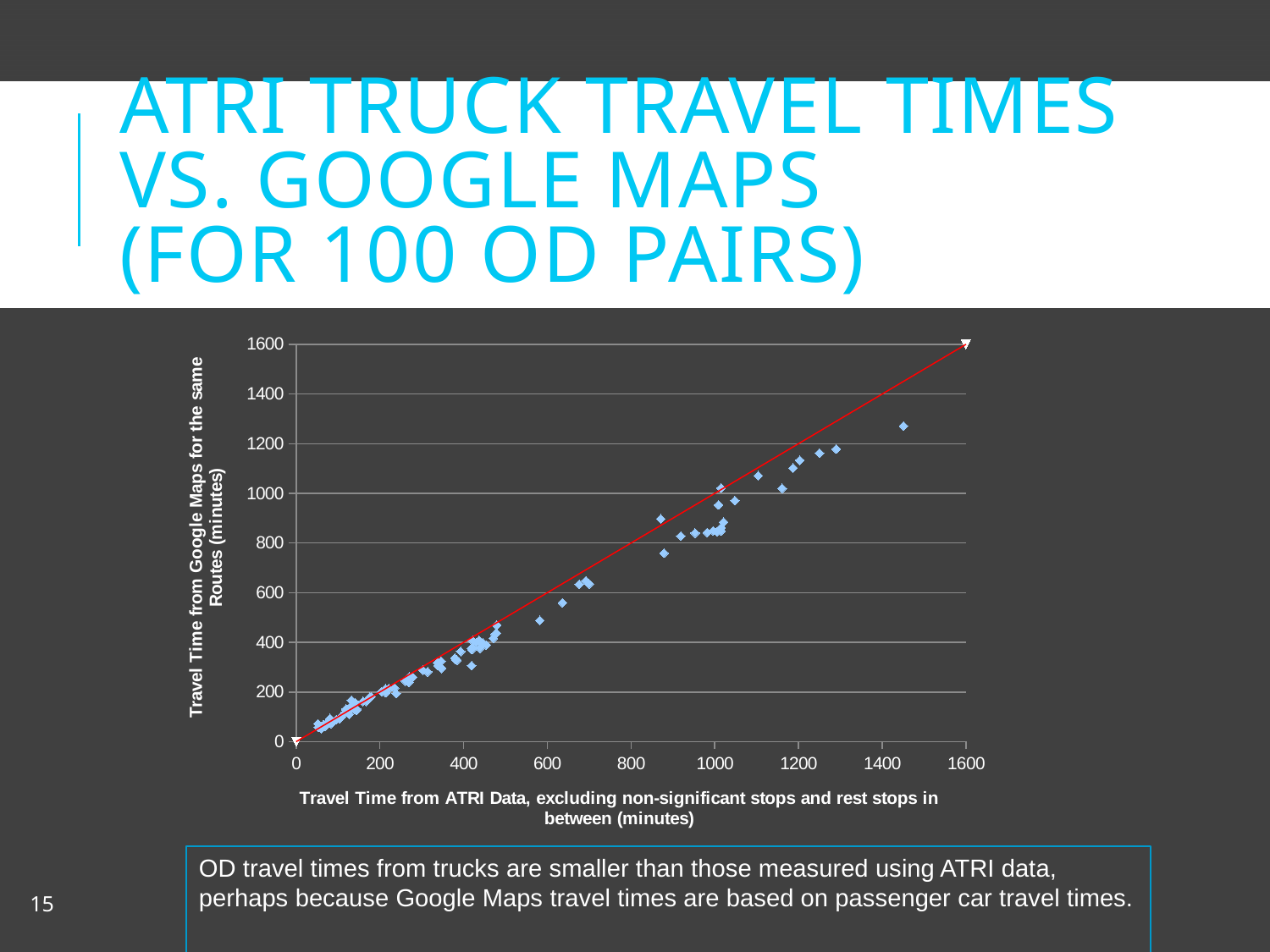
What is the label of the y axis? Travel Time from Google Maps for the same Routes (minutes) Do most of the plotted points lie above or below the red diagonal line? Below What is the interval between consecutive tick marks on the x axis? 200 Is the Google Maps travel time of the rightmost plotted data point greater or less than 1200 minutes? greater What is the label of the x axis? Travel Time from ATRI Data, excluding non-significant stops and rest stops in between (minutes) What is the highest tick value shown on the y axis? 1600 What is the highest tick value shown on the x axis? 1600 What kind of chart is shown on the slide? Scatter plot As the ATRI travel time on the x axis increases, do the Google Maps travel times on the y axis generally rise or fall? Rise Is the Google Maps travel time of the highest plotted data point greater or less than 1400 minutes? less Is the ATRI travel time of the rightmost plotted data point greater or less than 1400 minutes? greater